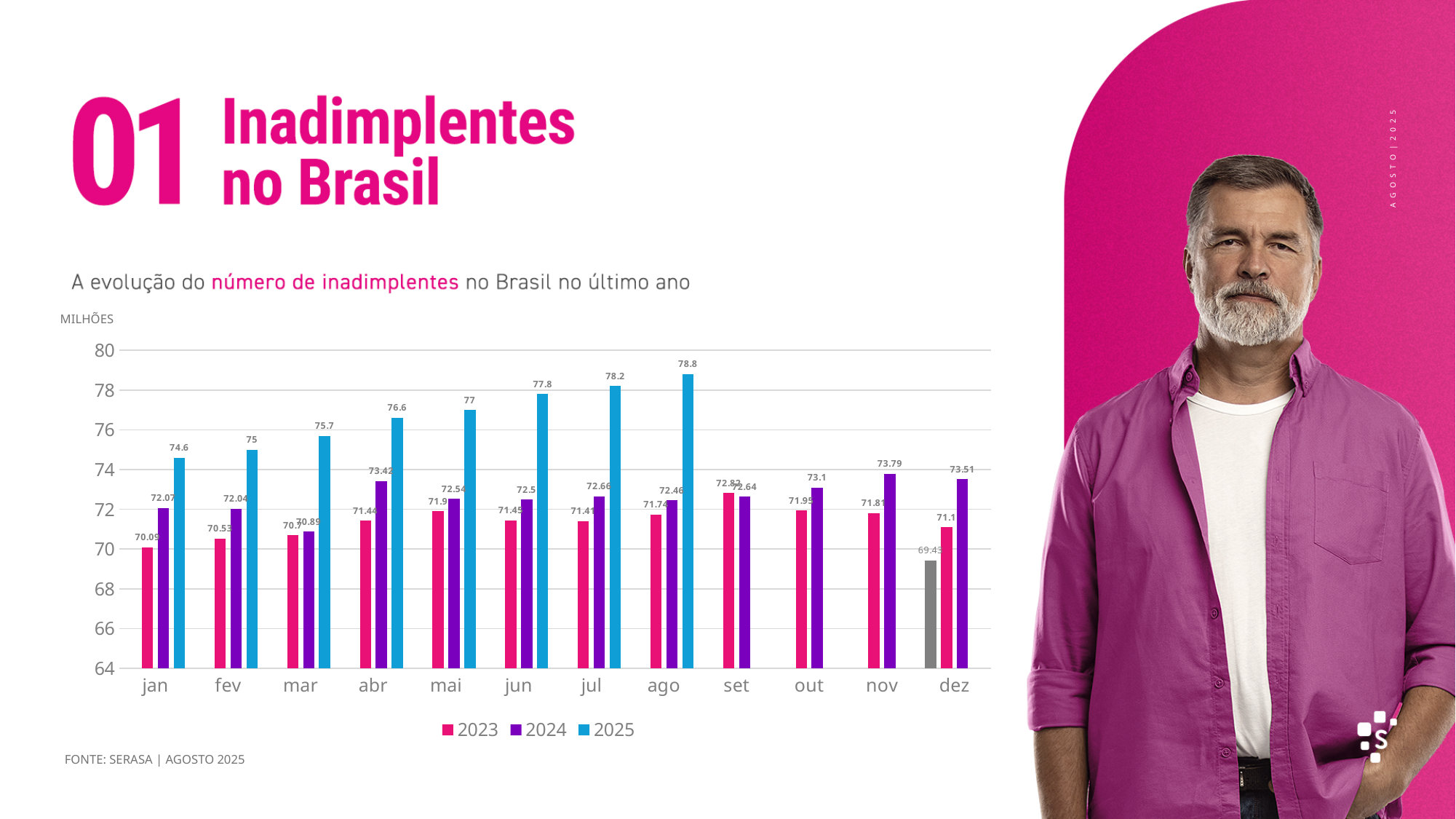
What is the difference between the 2024 and 2023 values in dez? 2.41 How many series does the legend list? 3 What is the difference between the 2025 values for ago and jan? 4.2 In which month is the 2025 value highest? ago What kind of chart is shown? bar chart In which month is the 2023 value lowest? jan How many months are shown on the x axis? 12 Is the value for 2023 in mar greater or less than 72? less What is the value for 2025 in ago? 78.8 In abr, which series has the larger value, 2023 or 2024? 2024 What is the value for 2023 in jan? 70.09 What is the value for 2024 in nov? 73.79